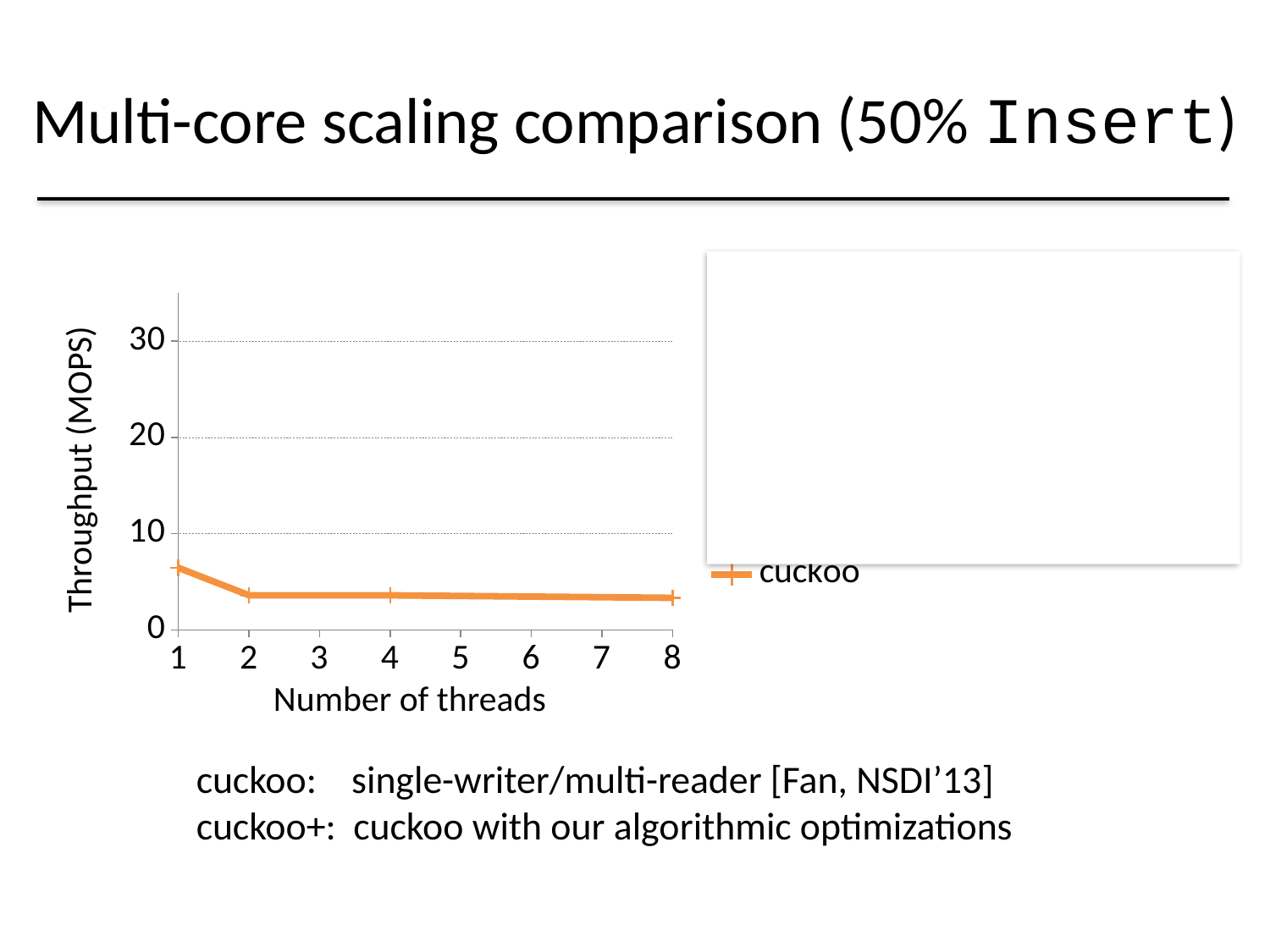
What kind of chart is shown on the slide? line chart Is the throughput of cuckoo at 1 thread greater or less than 10 MOPS? less Is the throughput of cuckoo at 8 threads greater or less than 10 MOPS? less What is the highest value shown on the y axis? 30 Which has the higher throughput for cuckoo: 1 thread or 2 threads? 1 thread How many data points are plotted for the cuckoo series? 4 Does the throughput of the cuckoo series rise or fall as the number of threads increases from 1 to 8? fall Is the throughput of cuckoo at 2 threads greater or less than 10 MOPS? less At which number of threads does the cuckoo series reach its highest throughput? 1 What is the title of the chart on the slide? Multi-core scaling comparison (50% Insert) What is the label of the y axis? Throughput (MOPS)